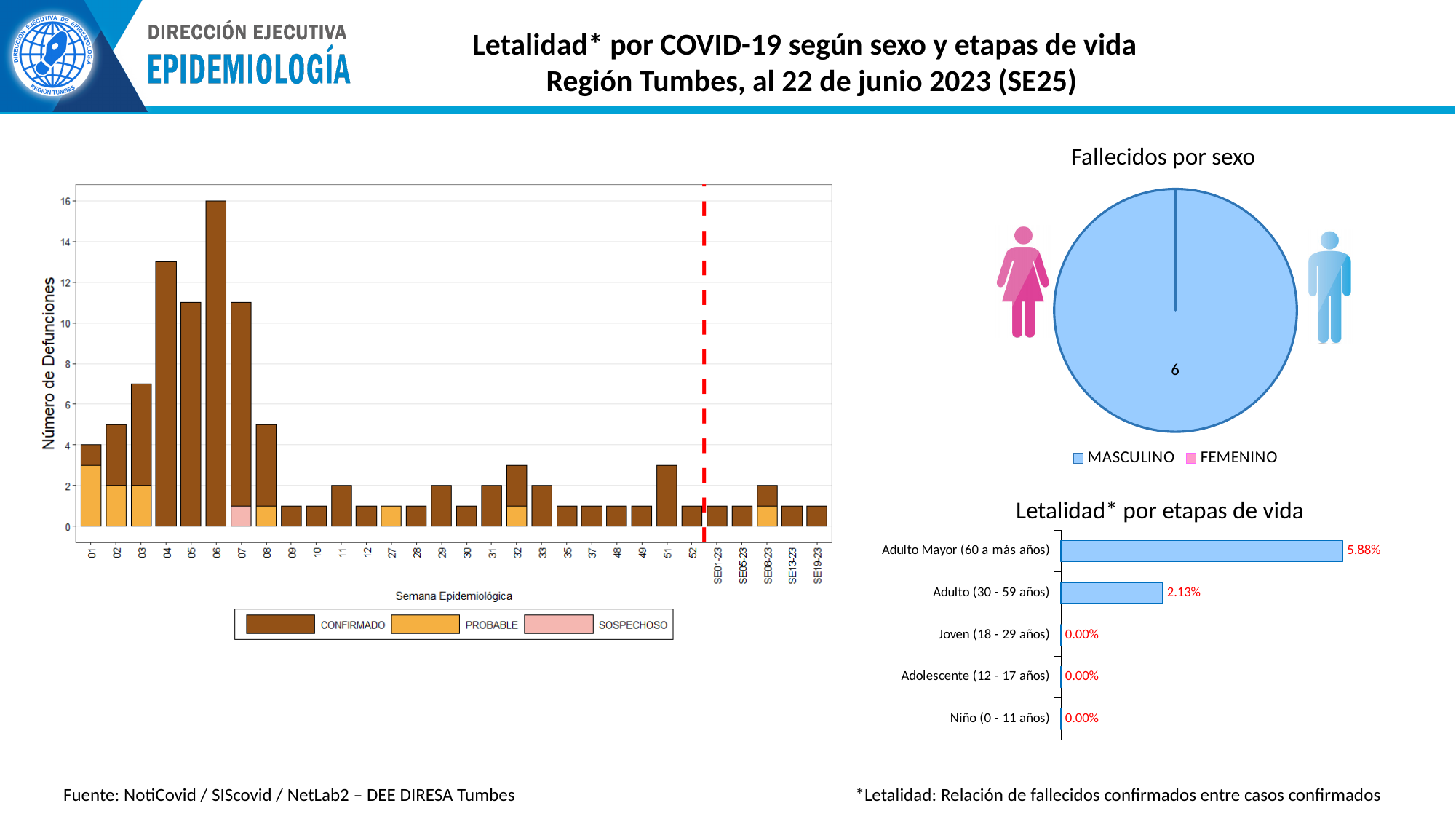
In the 'Letalidad* por etapas de vida' chart, what is the value for Adulto (30 - 59 años)? 2.13% How many series does the legend of the stacked bar chart on the left list? 3 How many series does the legend of the 'Fallecidos por sexo' chart list? 2 In the 'Letalidad* por etapas de vida' chart, what is the difference between the values for Adulto Mayor (60 a más años) and Adulto (30 - 59 años)? 3.75% In the stacked bar chart on the left (Número de Defunciones by Semana Epidemiológica), which week has the highest total number of deaths? 06 In the stacked bar chart on the left, is the total value for week 04 greater or less than 12? greater In the 'Letalidad* por etapas de vida' chart, what is the value for Adulto Mayor (60 a más años)? 5.88% In the 'Letalidad* por etapas de vida' chart, which age group has the highest value? Adulto Mayor (60 a más años) How many age-group categories are shown in the 'Letalidad* por etapas de vida' chart? 5 In the 'Fallecidos por sexo' pie chart, what value is shown for MASCULINO? 6 In the 'Letalidad* por etapas de vida' chart, what is the value for Joven (18 - 29 años)? 0.00% What kind of chart is 'Fallecidos por sexo'? Pie chart